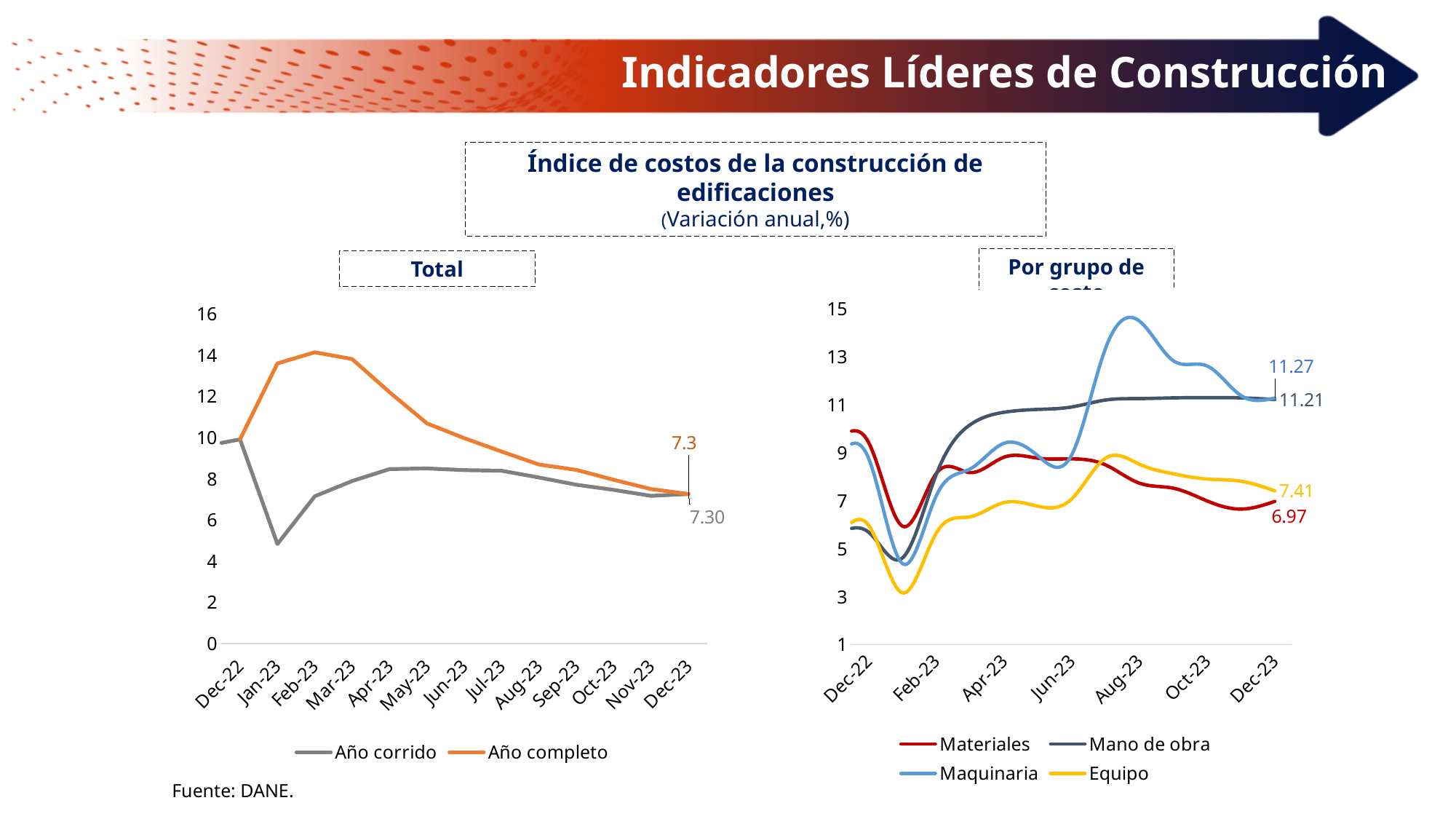
In the right chart ("Por grupo de costo"), what is the difference between Maquinaria and Materiales at Dec-23? 4.30 In the left chart ("Total"), does the Año completo line rise or fall from Mar-23 to Dec-23? Falls In the left chart ("Total"), is the value of Año corrido at Jan-23 greater or less than 6? less What kind of chart is the left chart titled "Total"? Line chart How many series does the legend of the left chart ("Total") list? 2 How many months are shown on the x axis of the left chart ("Total")? 13 How many series does the legend of the right chart ("Por grupo de costo") list? 4 In the left chart ("Total"), what is the value of Año completo at Dec-23? 7.3 In the left chart ("Total"), what is the value of Año corrido at Dec-23? 7.30 In the right chart ("Por grupo de costo"), which series has the lowest value at Dec-23? Materiales In the right chart ("Por grupo de costo"), is the value of Maquinaria at Aug-23 greater or less than 13? greater In the right chart ("Por grupo de costo"), what is the value of Maquinaria at Dec-23? 11.27